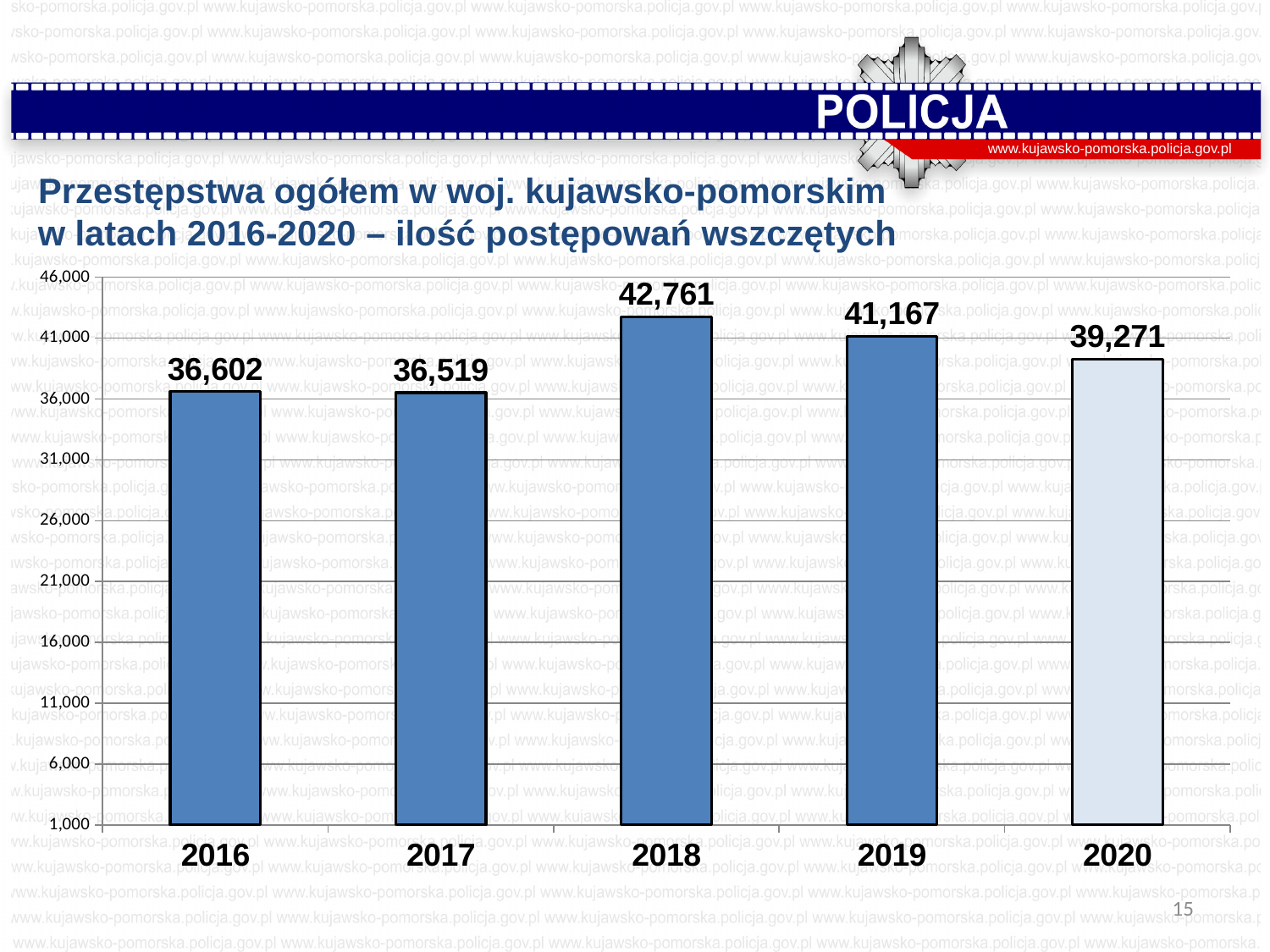
Which year has the lowest value? 2017 What is the value for 2018? 42,761 Which is larger, the value for 2019 or the value for 2020? 2019 What kind of chart is shown on the slide? bar chart Which year has the highest value? 2018 What is the difference between the values for 2016 and 2017? 83 What is the value for 2020? 39,271 Do the values rise or fall from 2018 to 2020? fall Is the value for 2018 greater or less than 41,000? greater What is the difference between the values for 2018 and 2019? 1,594 What is the value for 2016? 36,602 How many years are shown on the chart? 5